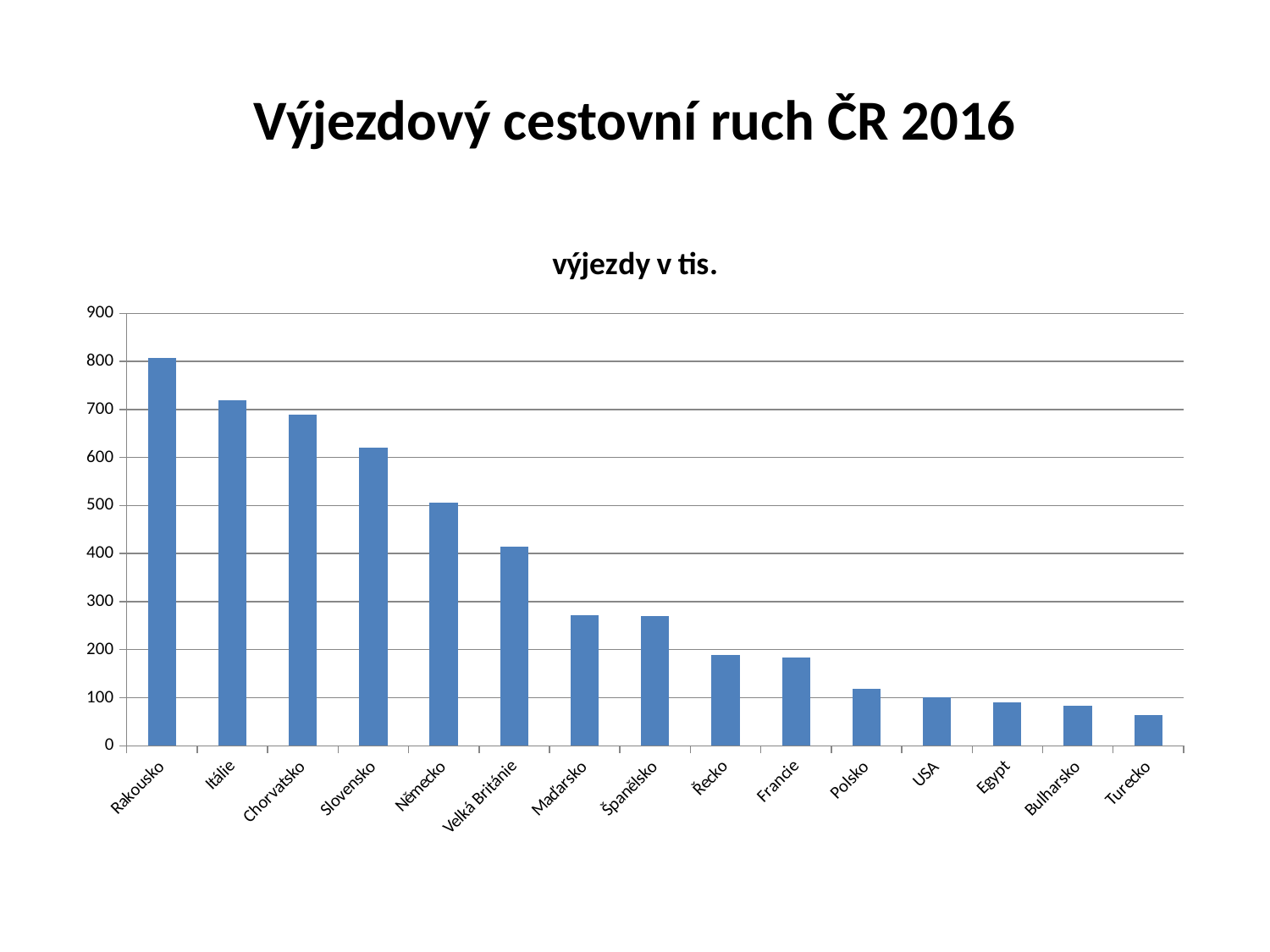
What is the title printed above the chart's plot area? výjezdy v tis. Which country has the lowest value in the chart? Turecko What type of chart is shown on the slide? bar chart Which country has the highest value in the chart? Rakousko How many countries are shown on the x axis of the chart? 15 Do the values rise or fall from left to right along the x axis? fall Is the value for Itálie greater or less than 700? greater Is the value for Maďarsko greater or less than 300? less Which has a larger value, Chorvatsko or Slovensko? Chorvatsko Is the value for Německo greater or less than 600? less